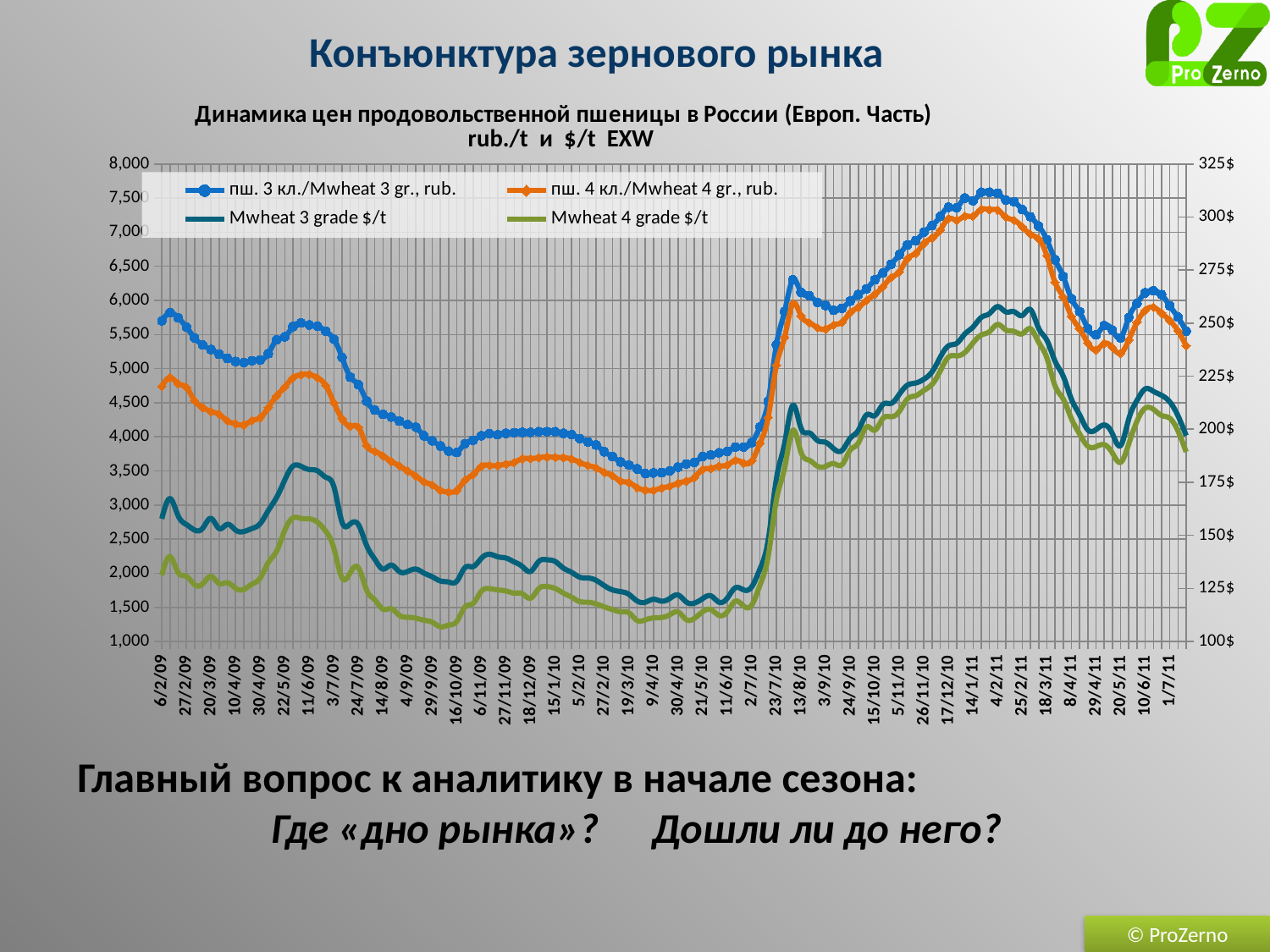
Between 11/6/09 and 16/10/09, does the пш. 4 кл./Mwheat 4 gr., rub. line rise or fall? fall How many series does the chart legend list? 4 Is the value for Mwheat 4 grade $/t on 16/10/09 greater or less than 125$? less On 4/2/11, which is higher: пш. 3 кл./Mwheat 3 gr., rub. or пш. 4 кл./Mwheat 4 gr., rub.? пш. 3 кл./Mwheat 3 gr., rub. Between 23/7/10 and 4/2/11, does the пш. 3 кл./Mwheat 3 gr., rub. line rise or fall? rise Which legend entry is shown with a blue line with circle markers? пш. 3 кл./Mwheat 3 gr., rub. Is the value for Mwheat 3 grade $/t on 4/2/11 greater or less than 225$? greater Is the value for пш. 3 кл./Mwheat 3 gr., rub. on 6/2/09 greater or less than 5,000? greater Which series reaches the highest point on the chart? пш. 3 кл./Mwheat 3 gr., rub. What is the title of the chart? Динамика цен продовольственной пшеницы в России (Европ. Часть) rub./t и $/t EXW What kind of chart is shown on the slide? line chart